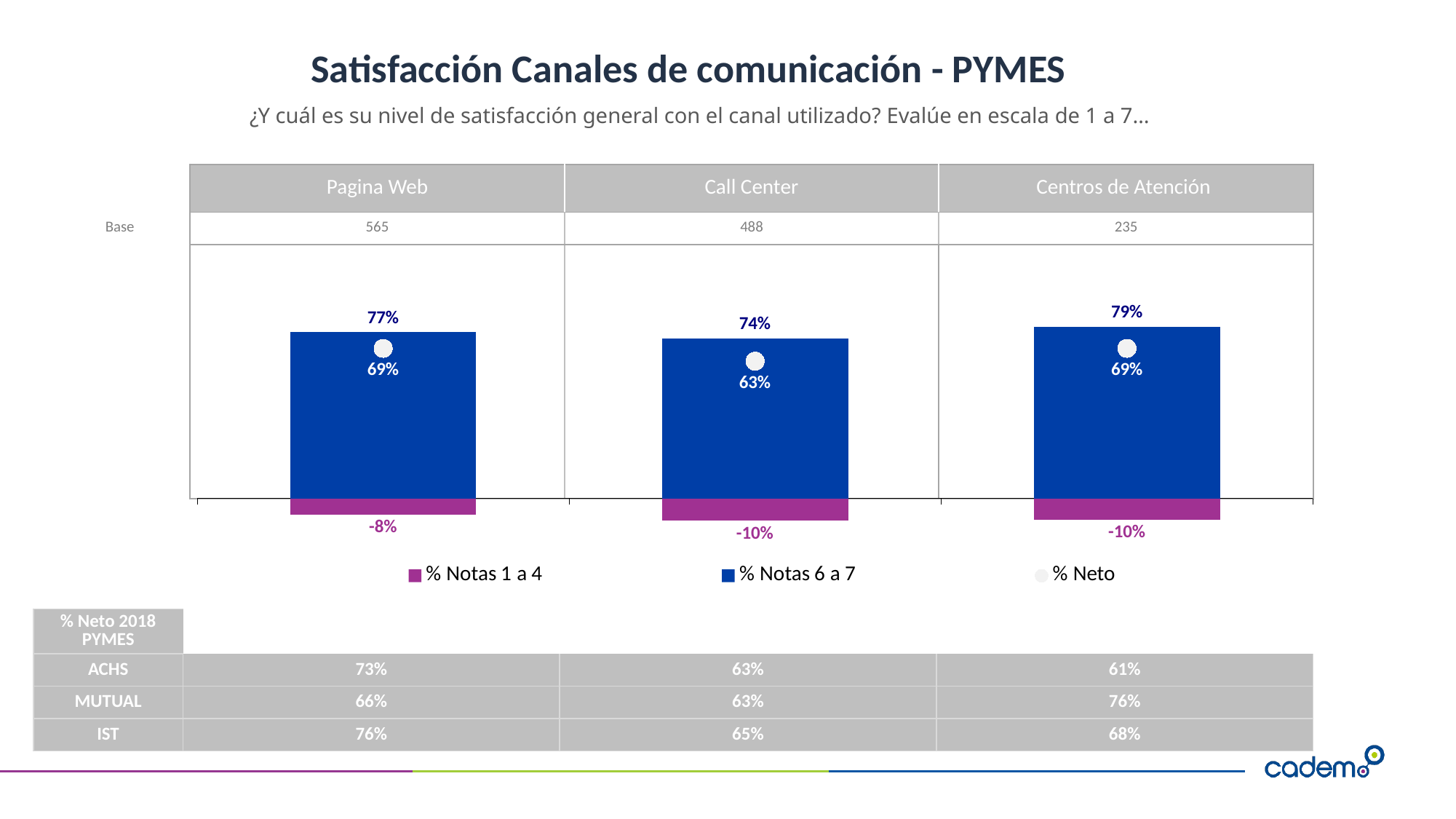
Which series is shown in purple in the chart legend? % Notas 1 a 4 What is the difference between the % Notas 6 a 7 values for Centros de Atención and Call Center? 5% What is the % Notas 6 a 7 value for Pagina Web? 77% How many channels (categories) are shown in the chart? 3 Which is larger, the % Notas 6 a 7 value for Pagina Web or for Call Center? Pagina Web Which channel has the lowest % Neto value? Call Center What kind of chart is shown on the slide? Bar chart Which channel has the highest % Notas 6 a 7 value? Centros de Atención What is the % Notas 1 a 4 value for Centros de Atención? -10% What is the % Notas 6 a 7 value for Centros de Atención? 79% What is the % Neto value for Call Center? 63% How many series does the chart legend list? 3